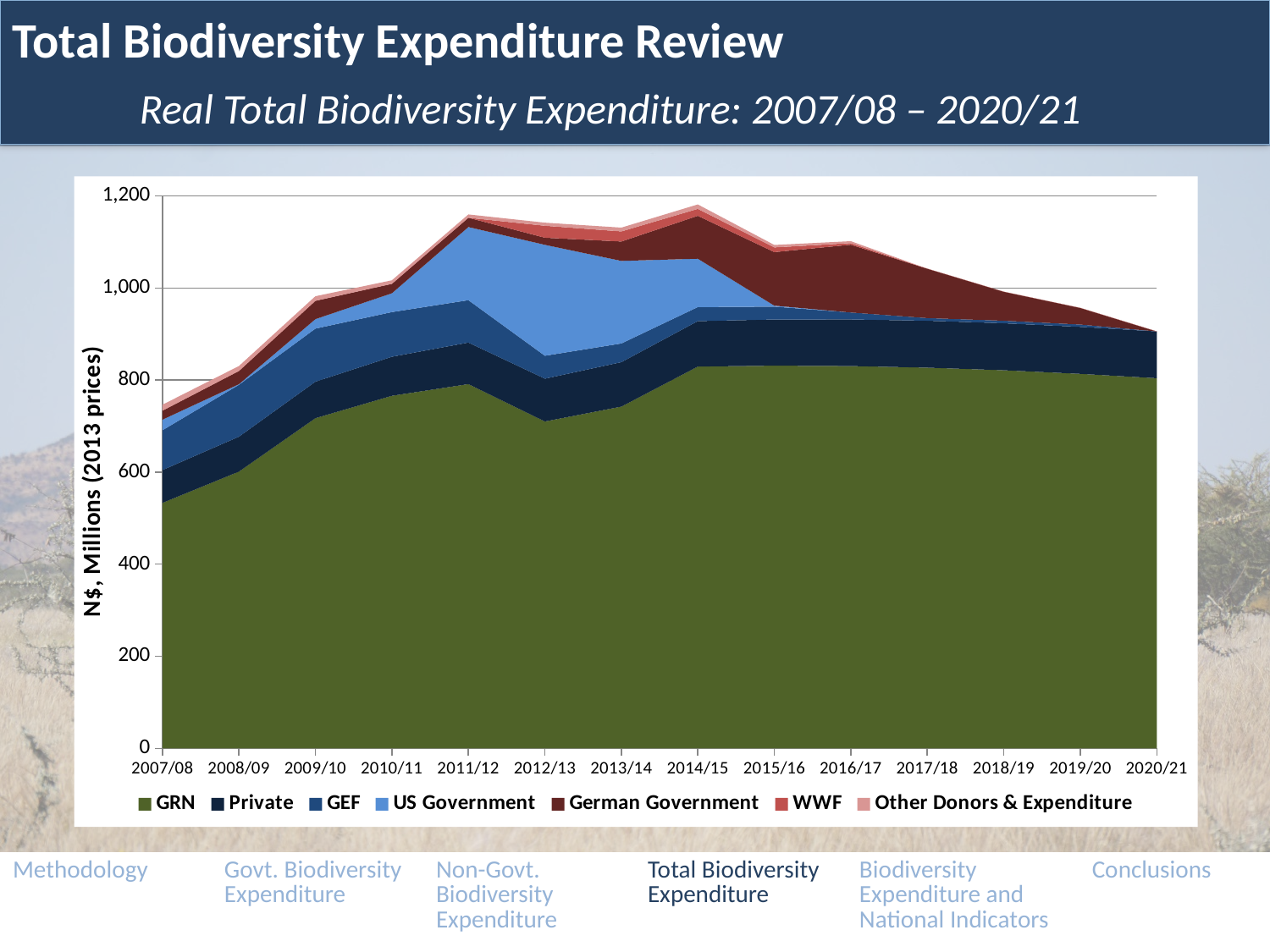
Does the total stacked value rise or fall from 2014/15 to 2020/21? fall Which series is larger in 2007/08, GRN or Private? GRN How many fiscal years are shown along the x axis? 14 Is the total stacked value for 2007/08 greater or less than 800? less Is the GRN value for 2014/15 greater or less than 800? greater Does the GRN value rise or fall from 2007/08 to 2011/12? rise Is the total stacked value for 2011/12 greater or less than 1,000? greater How many series does the legend list? 7 What kind of chart is shown on the slide? Stacked area chart What is the label on the y axis? N$, Millions (2013 prices)